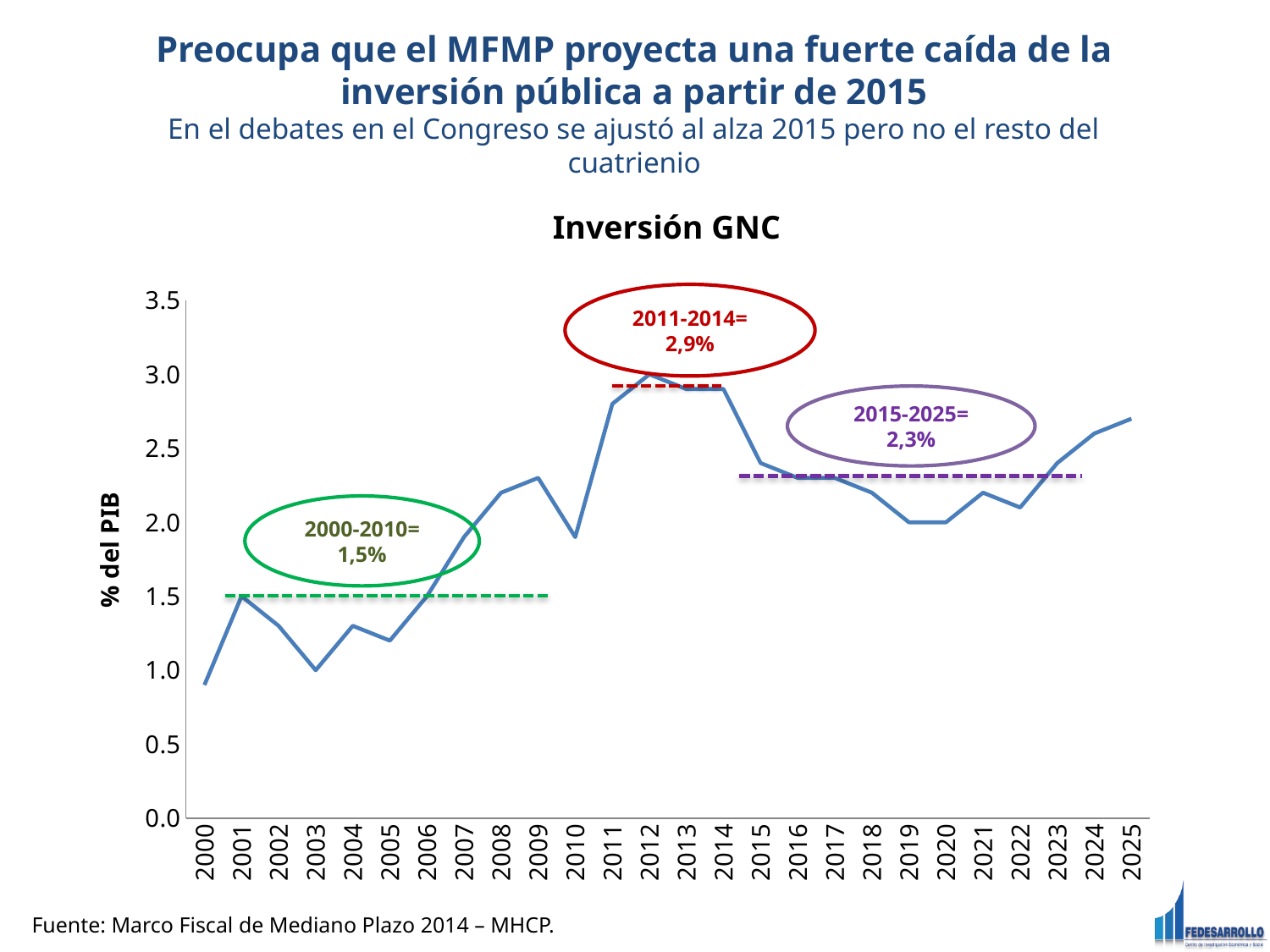
According to the annotation on the chart, what is the average value for 2015-2025? 2,3% According to the annotation on the chart, what is the average value for 2000-2010? 1,5% Which year has the larger value, 2003 or 2012? 2012 What is the title of the chart? Inversión GNC How many years are plotted along the x axis of the chart? 26 What is the label on the vertical axis of the chart? % del PIB According to the annotation on the chart, what is the average value for 2011-2014? 2,9% Do the values rise or fall from 2019 to 2025? rise Is the value for 2012 greater or less than 2.5? greater Is the value for 2010 greater or less than 2.0? less What kind of chart is shown on the slide? line chart Is the value for 2000 greater or less than 1.0? less